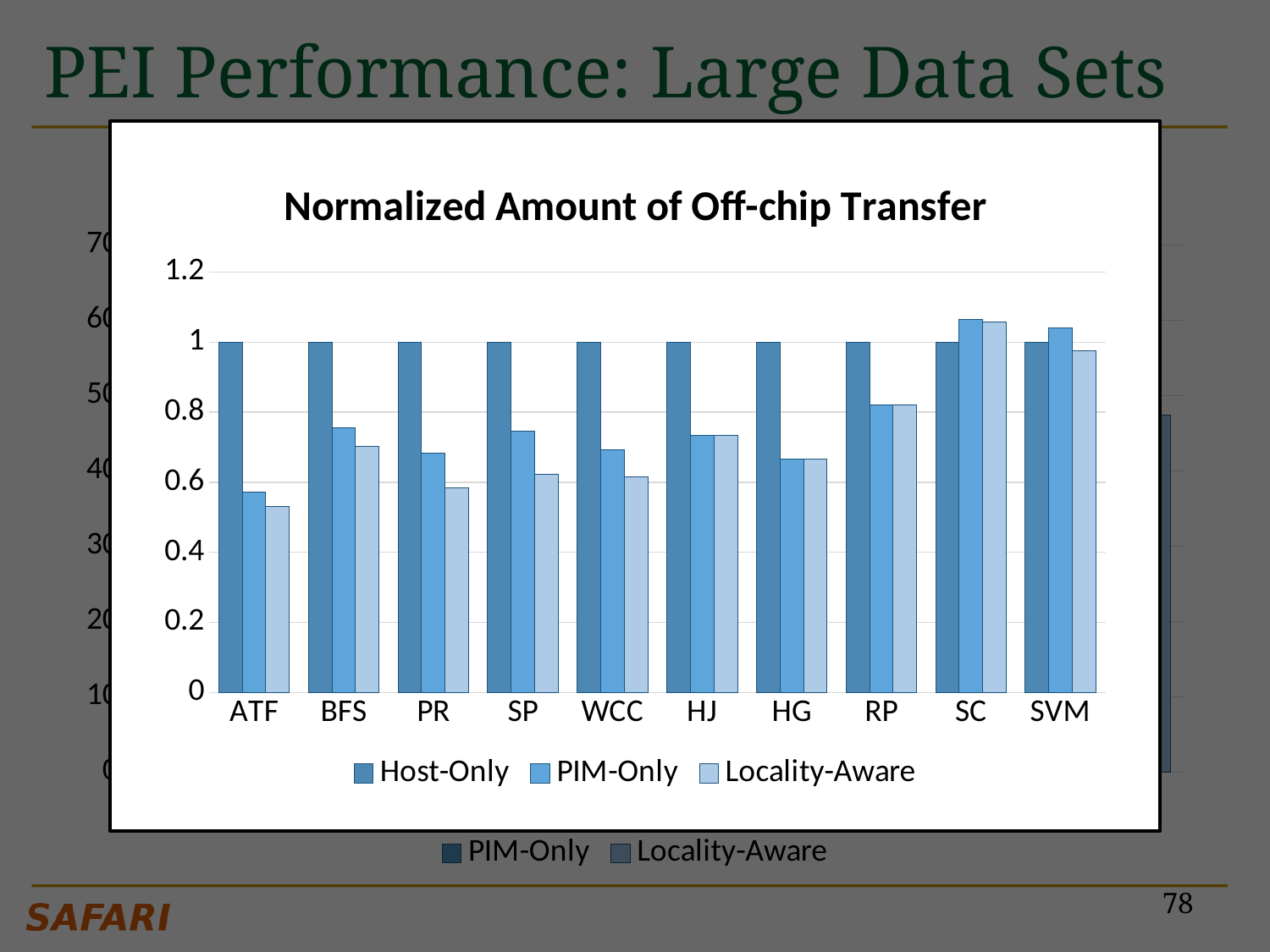
In the 'Normalized Amount of Off-chip Transfer' chart, is the PIM-Only value for HG greater or less than 0.6? greater In the 'Normalized Amount of Off-chip Transfer' chart, what is the Host-Only value for ATF? 1 What kind of chart is the 'Normalized Amount of Off-chip Transfer' chart? bar chart In the 'Normalized Amount of Off-chip Transfer' chart, which has the larger PIM-Only value, BFS or PR? BFS How many categories are shown on the x axis of the 'Normalized Amount of Off-chip Transfer' chart? 10 In the 'Normalized Amount of Off-chip Transfer' chart, is the Locality-Aware value for ATF greater or less than 0.6? less In the 'Normalized Amount of Off-chip Transfer' chart, is the PIM-Only value for SC greater or less than 1? greater How many series does the legend of the 'Normalized Amount of Off-chip Transfer' chart list? 3 In the 'Normalized Amount of Off-chip Transfer' chart, which category has the lowest Locality-Aware value? ATF In the 'Normalized Amount of Off-chip Transfer' chart, what are the three series listed in the legend? Host-Only, PIM-Only, Locality-Aware What is the title of the chart in the foreground of the slide? Normalized Amount of Off-chip Transfer